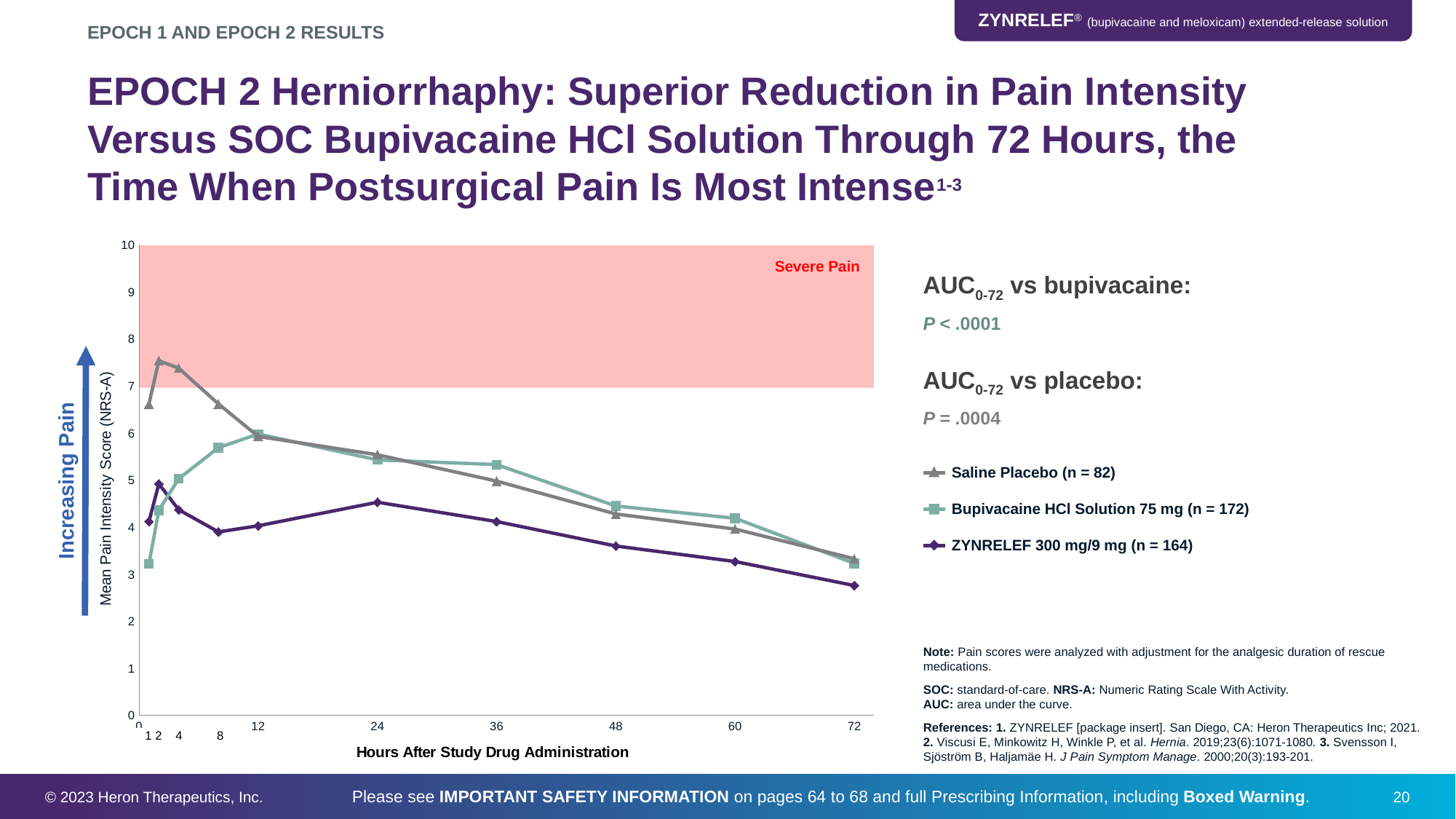
Is the value for ZYNRELEF 300 mg/9 mg at 24 hours greater or less than 5? less Is the value for ZYNRELEF 300 mg/9 mg at 72 hours greater or less than 3? less At 24 hours, which is higher: Bupivacaine HCl Solution 75 mg or ZYNRELEF 300 mg/9 mg? Bupivacaine HCl Solution 75 mg What kind of chart is shown on the slide? line chart Which series has the highest pain score at 2 hours? Saline Placebo (n = 82) Which series has the lowest pain score at 72 hours? ZYNRELEF 300 mg/9 mg (n = 164) Does the Saline Placebo line rise or fall from 2 hours to 72 hours? fall What is the label of the x axis? Hours After Study Drug Administration Is the value for Saline Placebo at 2 hours greater or less than 7? greater What label is shown in the shaded red region at the top of the chart? Severe Pain How many series does the legend list? 3